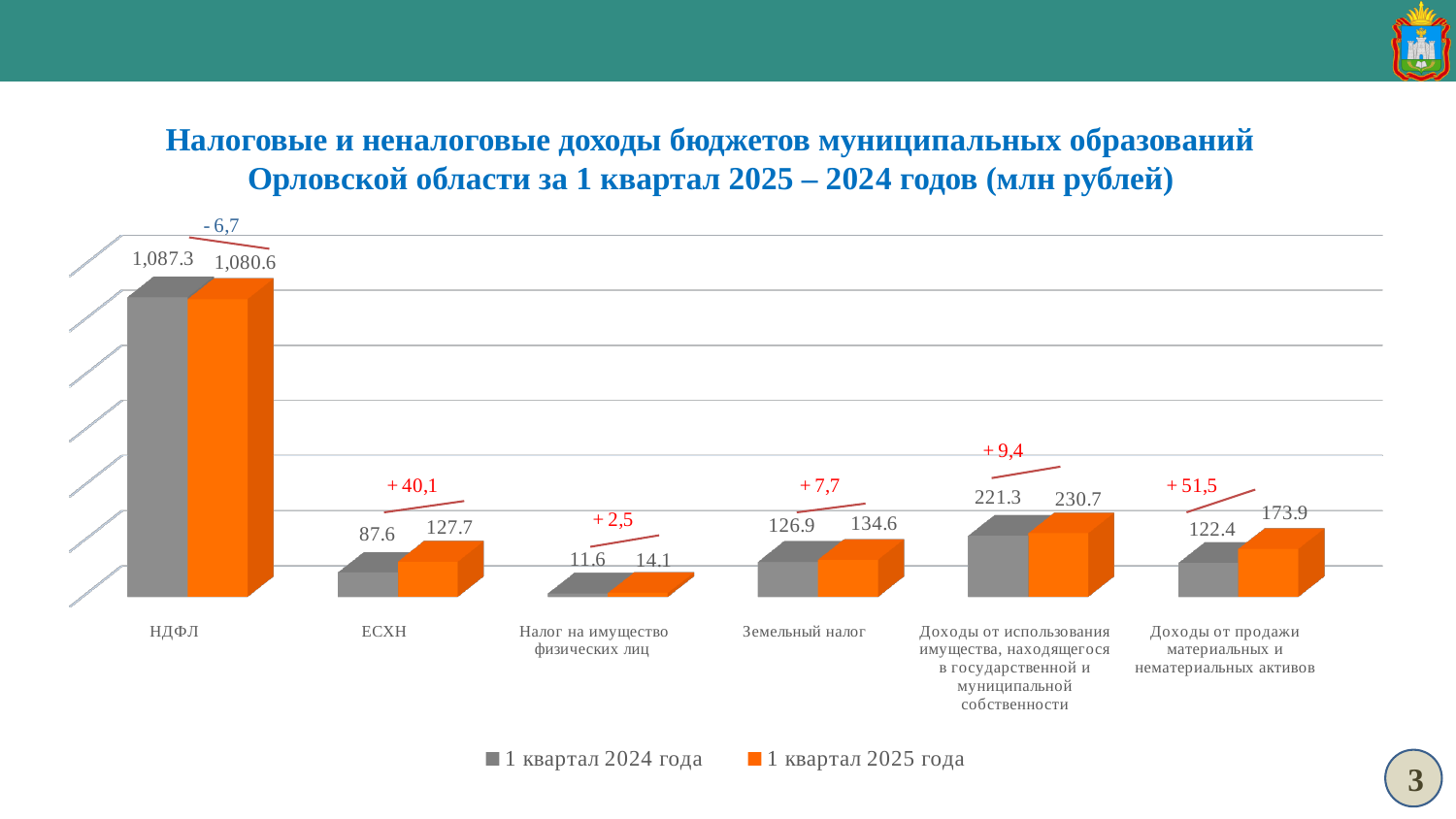
What is the value for Земельный налог in the 1 квартал 2024 года series? 126.9 Which category has the lowest value in the 1 квартал 2024 года series? Налог на имущество физических лиц Which is larger for НДФЛ: the 1 квартал 2024 года value or the 1 квартал 2025 года value? 1 квартал 2024 года What is the value for ЕСХН in the 1 квартал 2025 года series? 127.7 What change is annotated in red above the bars for Доходы от продажи материальных и нематериальных активов? + 51,5 Which category has the highest value in the 1 квартал 2025 года series? НДФЛ What is the difference between the 1 квартал 2025 года and 1 квартал 2024 года values for ЕСХН? 40.1 What is the value for НДФЛ in the 1 квартал 2024 года series? 1,087.3 What is the value for Доходы от продажи материальных и нематериальных активов in the 1 квартал 2025 года series? 173.9 How many series does the legend list? 2 What kind of chart is shown on the slide? Bar chart How many categories are shown on the x axis? 6